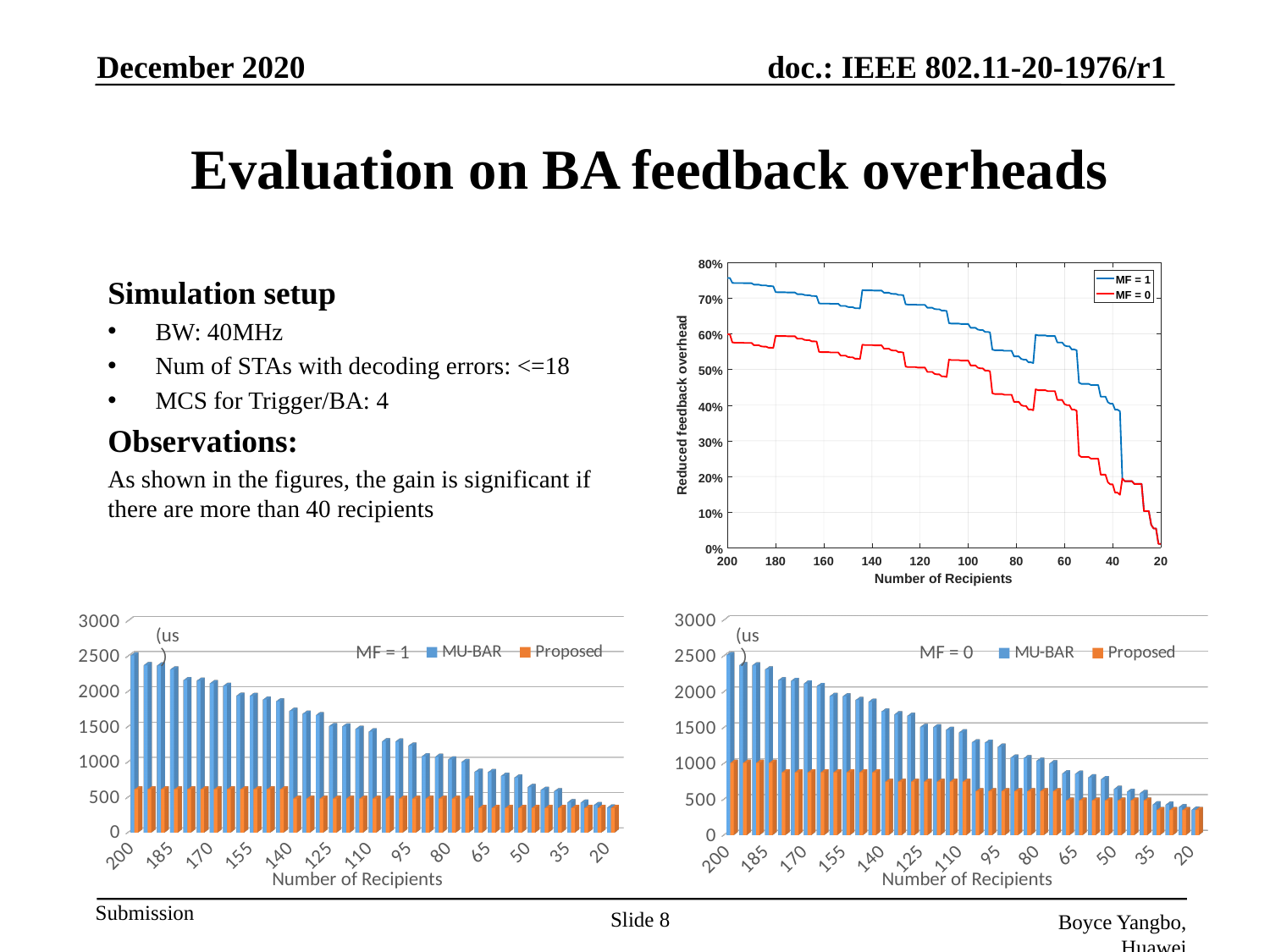
In the bottom-right 'MF = 0' bar chart, is the Proposed value at 200 recipients greater or less than 1500? less In the bottom-left 'MF = 1' bar chart, is the MU-BAR value at 200 recipients greater or less than 2000? greater What type of chart is the top-right chart titled 'Reduced feedback overhead'? line chart What type of chart is the bottom-left chart labelled 'MF = 1'? bar chart In the top-right line chart, is the MF = 1 value at 200 recipients greater or less than 70%? greater In the top-right line chart, do the values rise or fall moving along the x axis from 200 recipients to 20 recipients? fall In the top-right line chart, what colour is the MF = 0 line? red In the top-right line chart, how many series does the legend list? 2 In the bottom-left 'MF = 1' bar chart, at which number of recipients is the MU-BAR value highest? 200 In the top-right line chart, which series is higher at 200 recipients, MF = 1 or MF = 0? MF = 1 In the bottom-left 'MF = 1' bar chart, which series does the legend list besides MU-BAR? Proposed